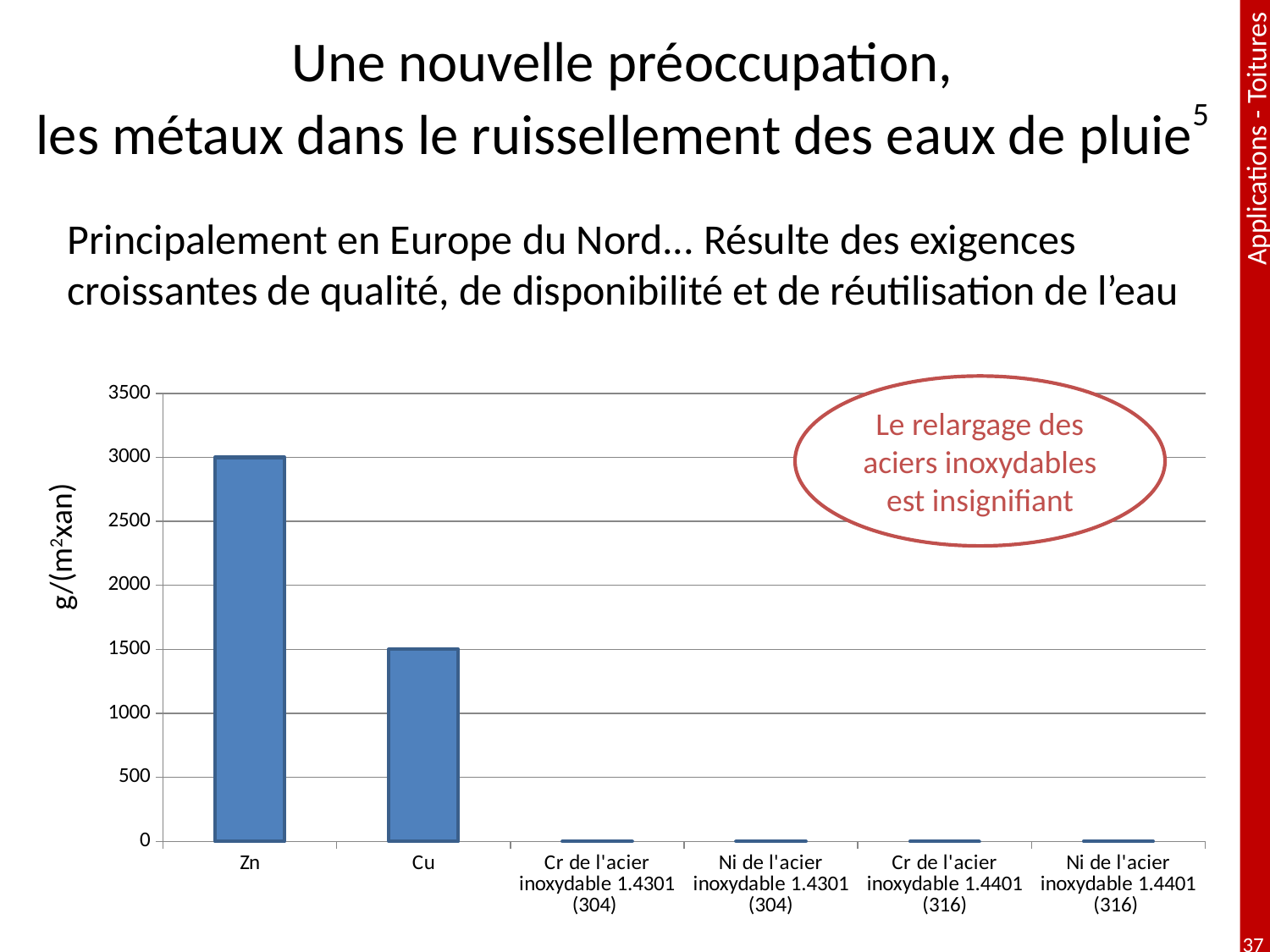
Do the values generally rise or fall from left to right along the x axis? fall Which is larger, the value for Zn or the value for Cu? Zn What kind of chart is shown on the slide? bar chart What is the highest value shown on the y axis of the chart? 3500 Which category has the highest value in the chart? Zn Is the value for Cu greater or less than 1000? greater Is the value for Cr de l'acier inoxydable 1.4301 (304) greater or less than 500? less Is the value for Zn greater or less than 2500? greater Which is larger, the value for Cu or the value for Ni de l'acier inoxydable 1.4401 (316)? Cu How many categories are plotted on the x axis of the chart? 6 What is the unit shown on the y axis of the chart? g/(m²xan)